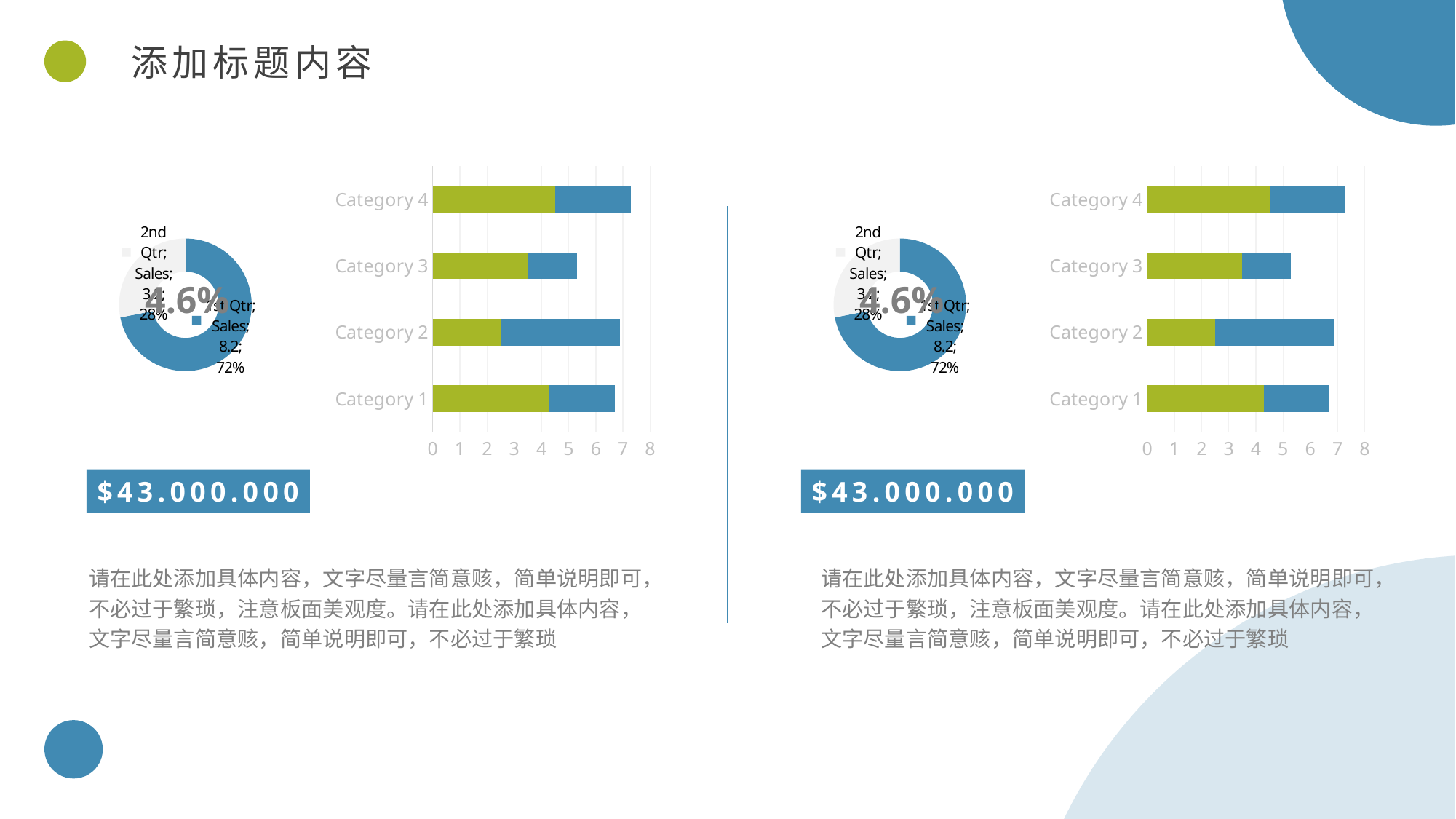
In the right doughnut chart, what sales value is labelled for 1st Qtr? 8.2 In the left bar chart, which is larger, the total bar for Category 2 or the total bar for Category 3? Category 2 How many categories are shown in the left bar chart? 4 What kind of chart is the left bar chart on the slide? Stacked bar chart In the right bar chart, is the total value for Category 4 greater or less than 7? greater In the right bar chart, which category has the shortest green segment? Category 2 In the right bar chart, which category has the longest blue segment? Category 2 In the left doughnut chart, what percentage share is shown for 1st Qtr? 72% In the right doughnut chart, which quarter has the larger share, 1st Qtr or 2nd Qtr? 1st Qtr In the left bar chart, is the total value for Category 3 greater or less than 6? less In the left bar chart, which category has the shortest total bar? Category 3 In the left doughnut chart, what percentage share is shown for 2nd Qtr? 28%